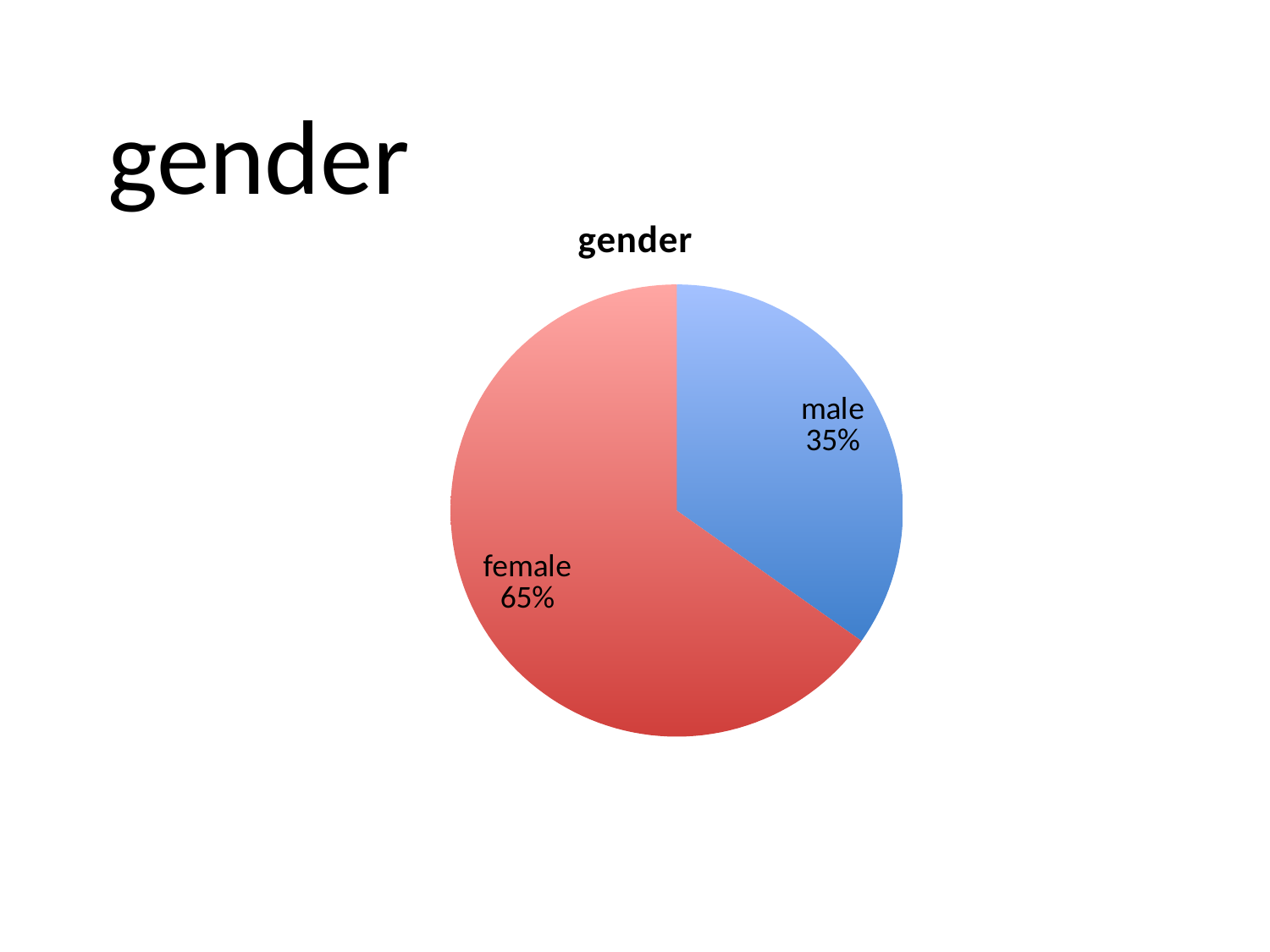
How many slices does the pie chart have? 2 What is the title of the chart? gender Which is larger, the female share or the male share? female What type of chart is shown on the slide? pie chart What percentage of the pie is female? 65% Which category has the largest share of the pie? female What colour is the male slice? blue What is the difference in percentage points between the female and male shares? 30 Which category has the smallest share of the pie? male What share of the pie does the female slice represent? 65% What percentage of the pie is male? 35%